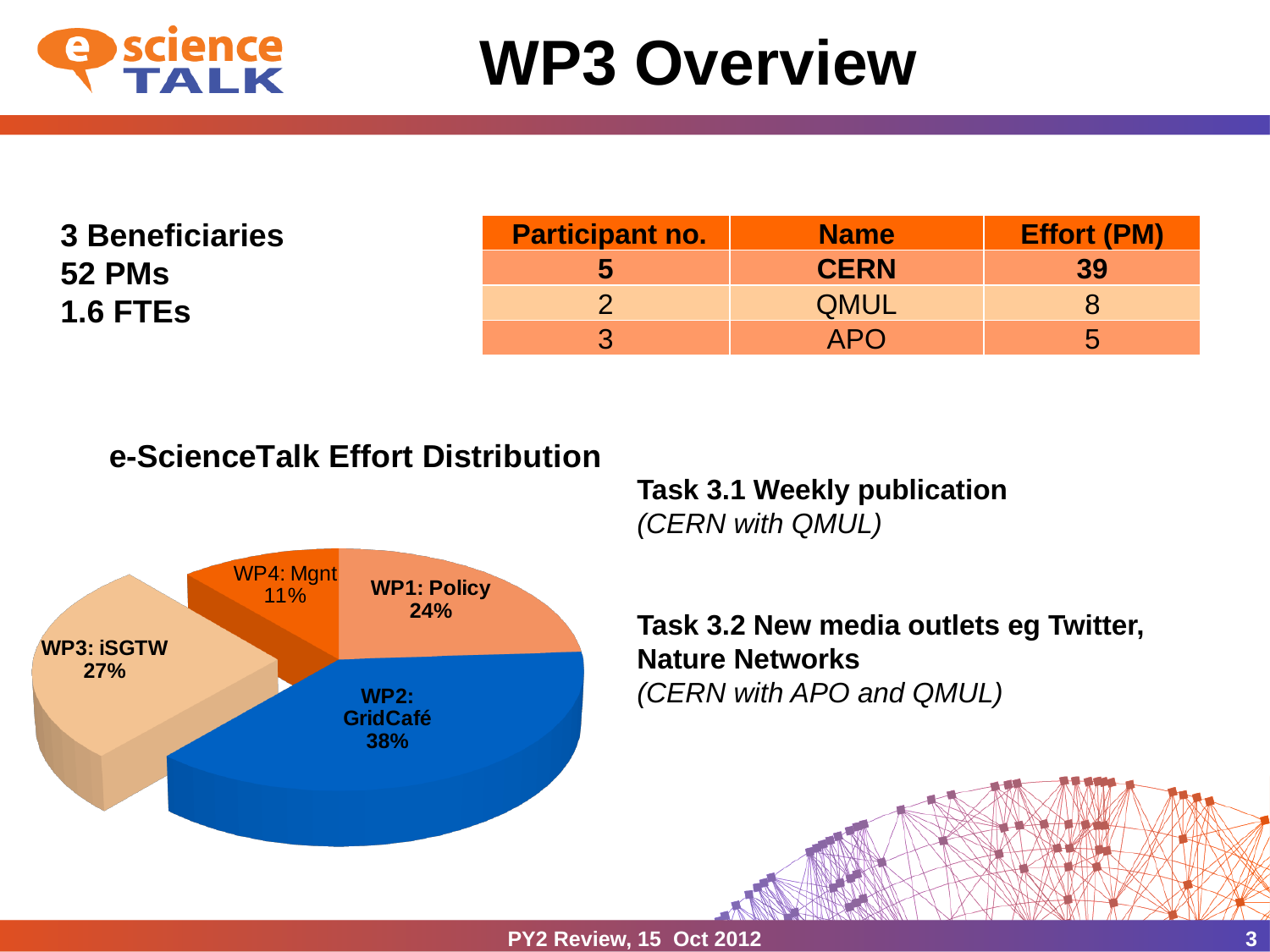
What is the title of the pie chart on the slide? e-ScienceTalk Effort Distribution How many slices does the pie chart have? 4 What colour is the WP2: GridCafé slice in the pie chart? blue What share of effort does WP3: iSGTW have in the pie chart? 27% What kind of chart is shown on the slide? pie chart What share of effort does WP4: Mgnt have in the pie chart? 11% What is the difference in percentage points between the WP2: GridCafé and WP4: Mgnt shares? 27 What share of effort does WP2: GridCafé have in the pie chart? 38% Which work package has the smallest share in the pie chart? WP4: Mgnt Which has a larger share in the pie chart, WP3: iSGTW or WP1: Policy? WP3: iSGTW Which work package has the largest share in the pie chart? WP2: GridCafé